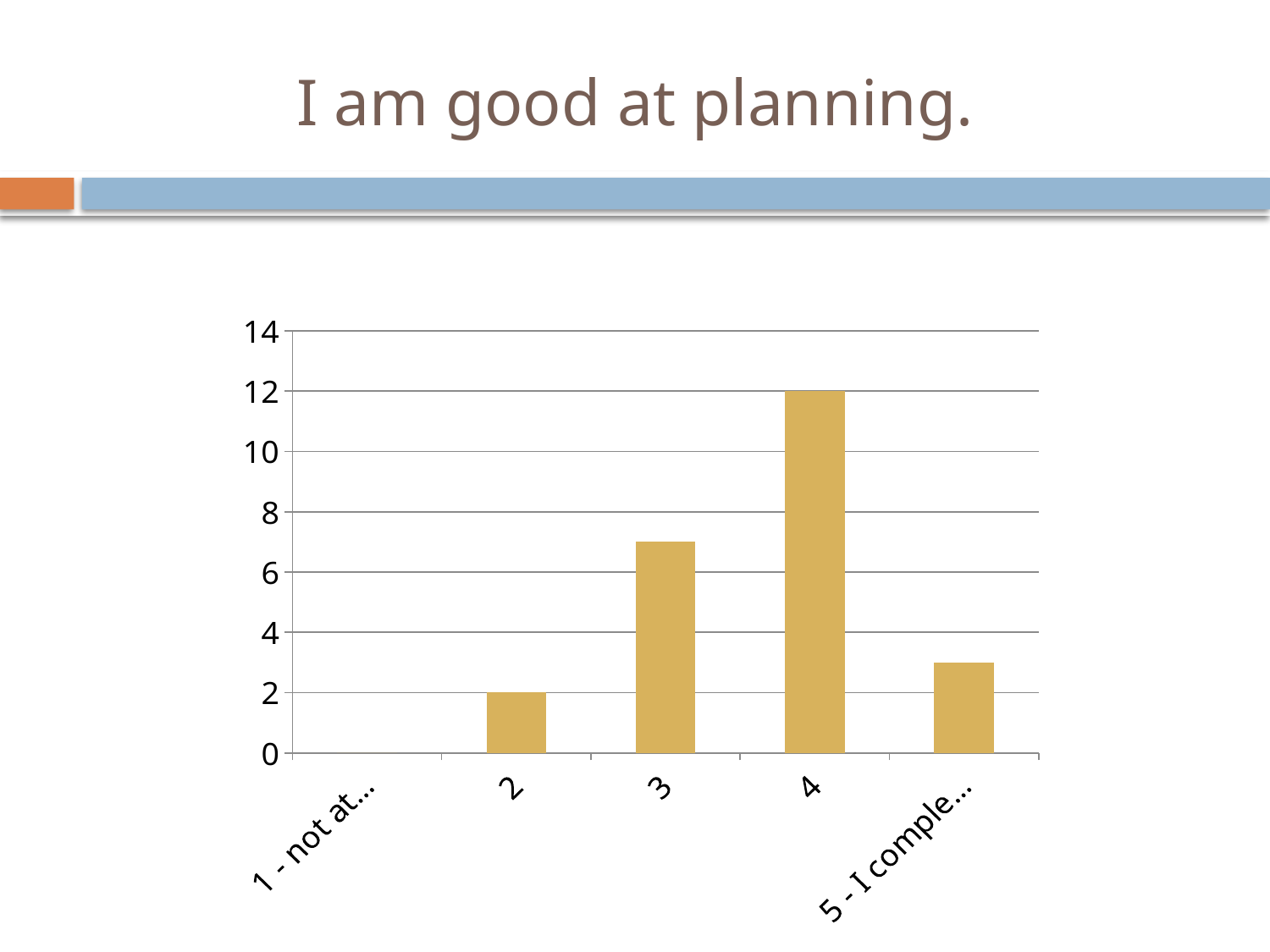
Which category has the highest bar? 4 How many categories are shown on the x axis? 5 What kind of chart is shown on the slide? bar chart What is the value for category 4? 12 What is the title of the slide? I am good at planning. Is the value for the category '5 - I comple...' greater or less than 4? less What is the difference between the values for category 4 and category 2? 10 What is the value for category 2? 2 Is the value for category 3 greater or less than 8? less Do the values rise or fall from category 2 to category 4? rise Which is larger, the value for category 3 or the value for category '5 - I comple...'? 3 Is the value for category 3 greater or less than 6? greater